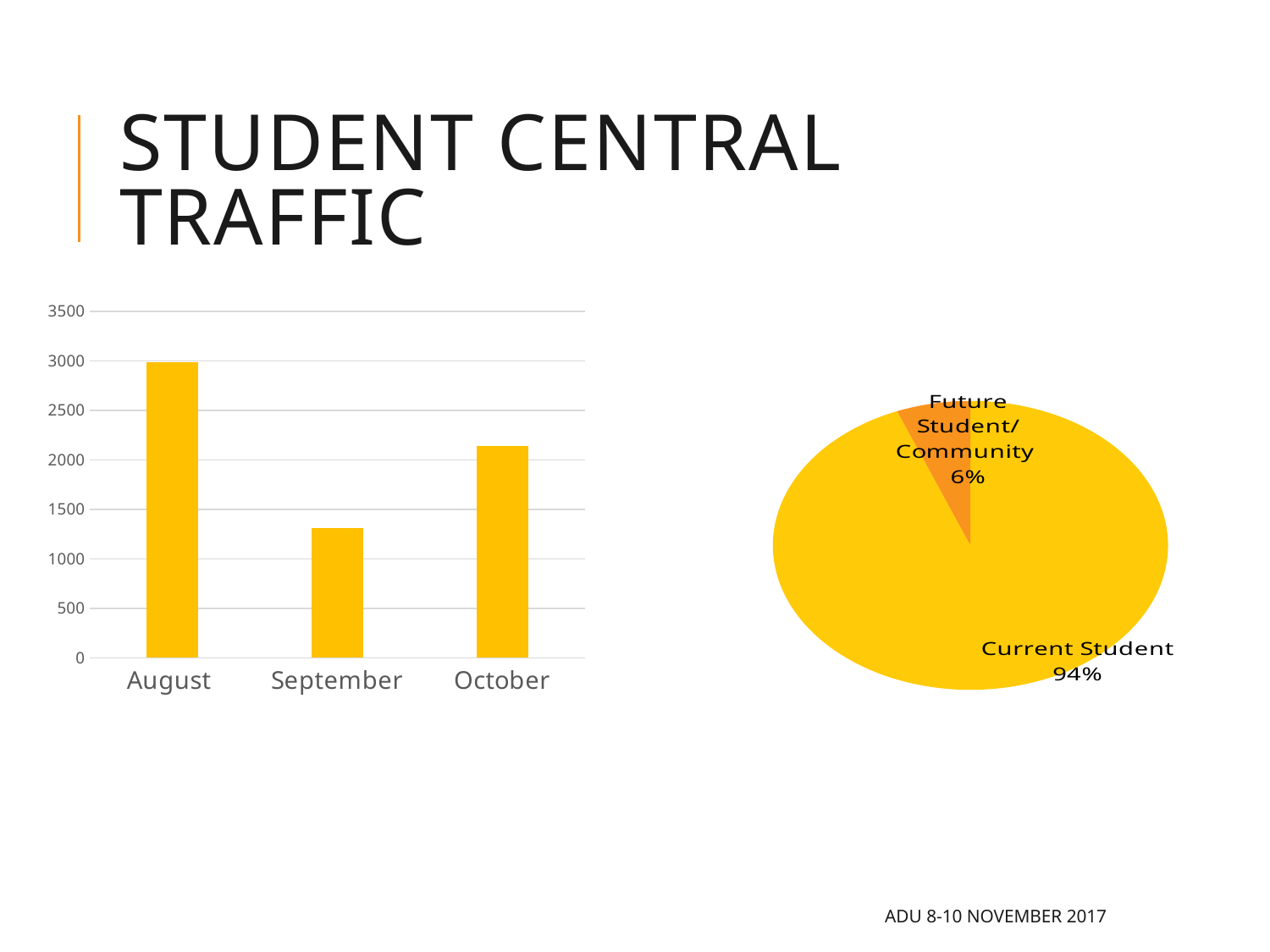
What kind of chart is the chart on the left of the slide? bar chart In the bar chart on the left, which is larger, the value for August or the value for October? August In the bar chart on the left, which month has the highest bar? August In the pie chart on the right, how many slices does the pie have? 2 In the pie chart on the right, what share of the pie is Future Student/Community? 6% In the pie chart on the right, what share of the pie is Current Student? 94% What kind of chart is the chart on the right of the slide? pie chart In the bar chart on the left, is the value for August greater or less than 2500? greater In the bar chart on the left, how many months are shown on the x axis? 3 In the bar chart on the left, is the value for September greater or less than 1500? less In the bar chart on the left, which month has the lowest bar? September In the bar chart on the left, is the value for October greater or less than 2000? greater